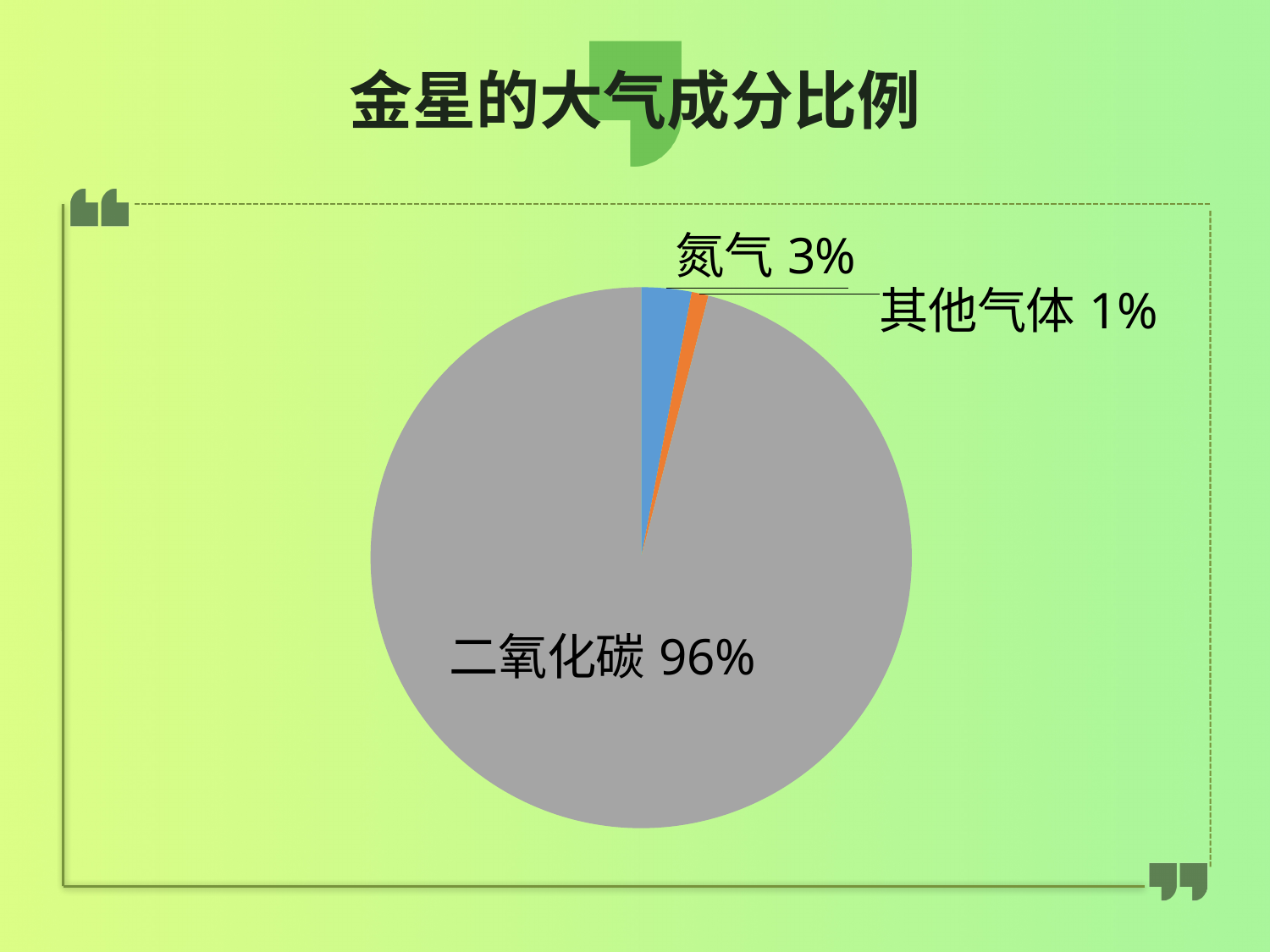
Which is larger, the value for 氮气 or the value for 其他气体? 氮气 What is the value shown for 其他气体? 1% What is the difference between the values for 氮气 and 其他气体? 2% How many slices does the pie chart have? 3 What is the difference between the values for 二氧化碳 and 氮气? 93% Which category has the smallest slice of the pie? 其他气体 What is the value shown for 氮气? 3% What is the title of the chart? 金星的大气成分比例 What colour is the slice for 二氧化碳? grey Which category has the largest slice of the pie? 二氧化碳 What share of the pie does 二氧化碳 take? 96% What type of chart is shown on the slide? pie chart